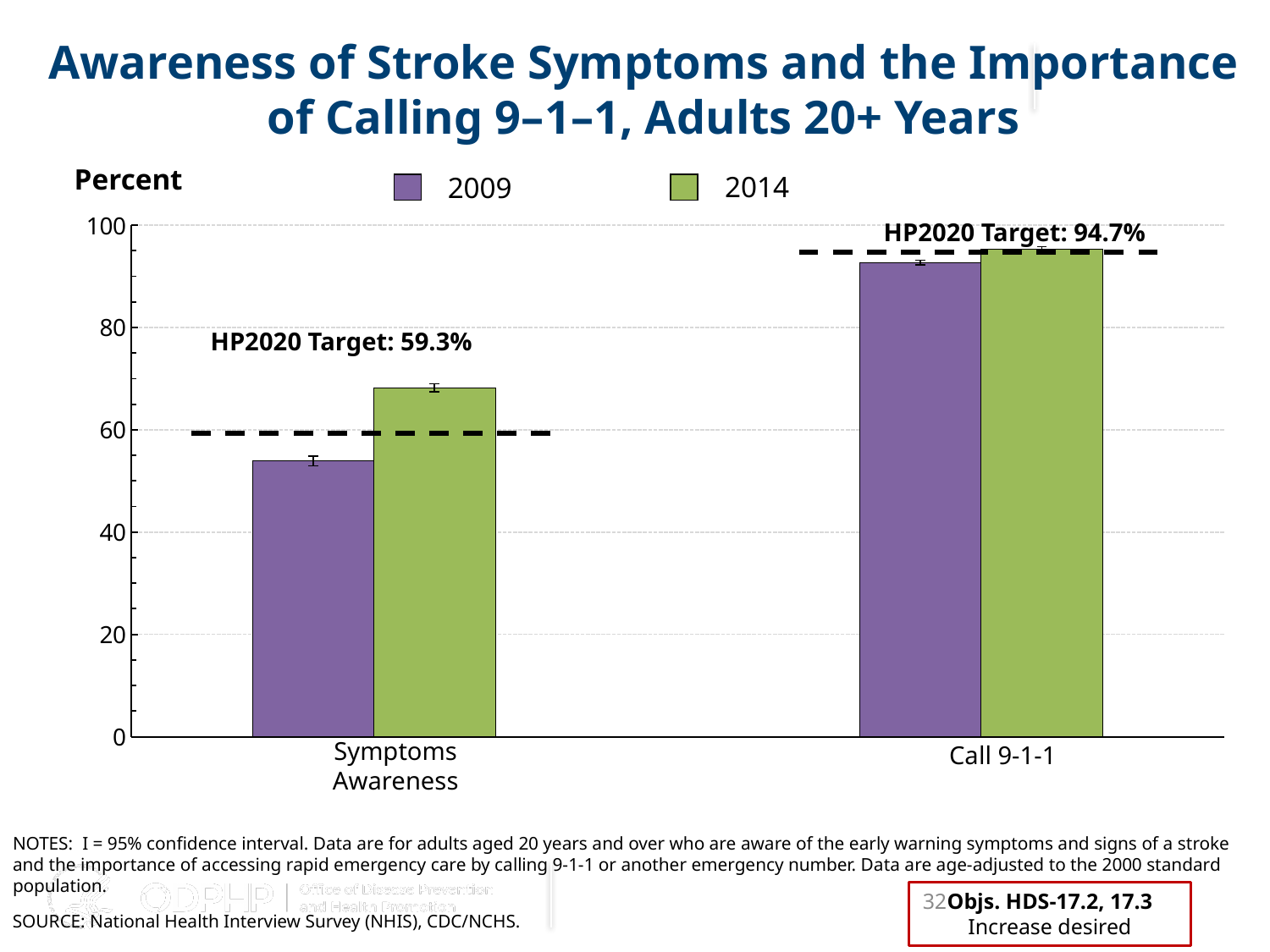
Is the 2009 value for Symptoms Awareness greater or less than 60? less Which bar has the lowest value in the chart? Symptoms Awareness, 2009 Is the 2014 value for Symptoms Awareness greater or less than 60? greater What is the label on the y axis? Percent Is the 2009 value for Call 9-1-1 greater or less than 80? greater What is the HP2020 Target shown for Symptoms Awareness? 59.3% What kind of chart is shown on the slide? bar chart Which year does the purple bar represent? 2009 How many series does the legend list? 2 What is the HP2020 Target shown for Call 9-1-1? 94.7% For Symptoms Awareness, which year has the larger value, 2009 or 2014? 2014 How many categories are shown on the x axis? 2